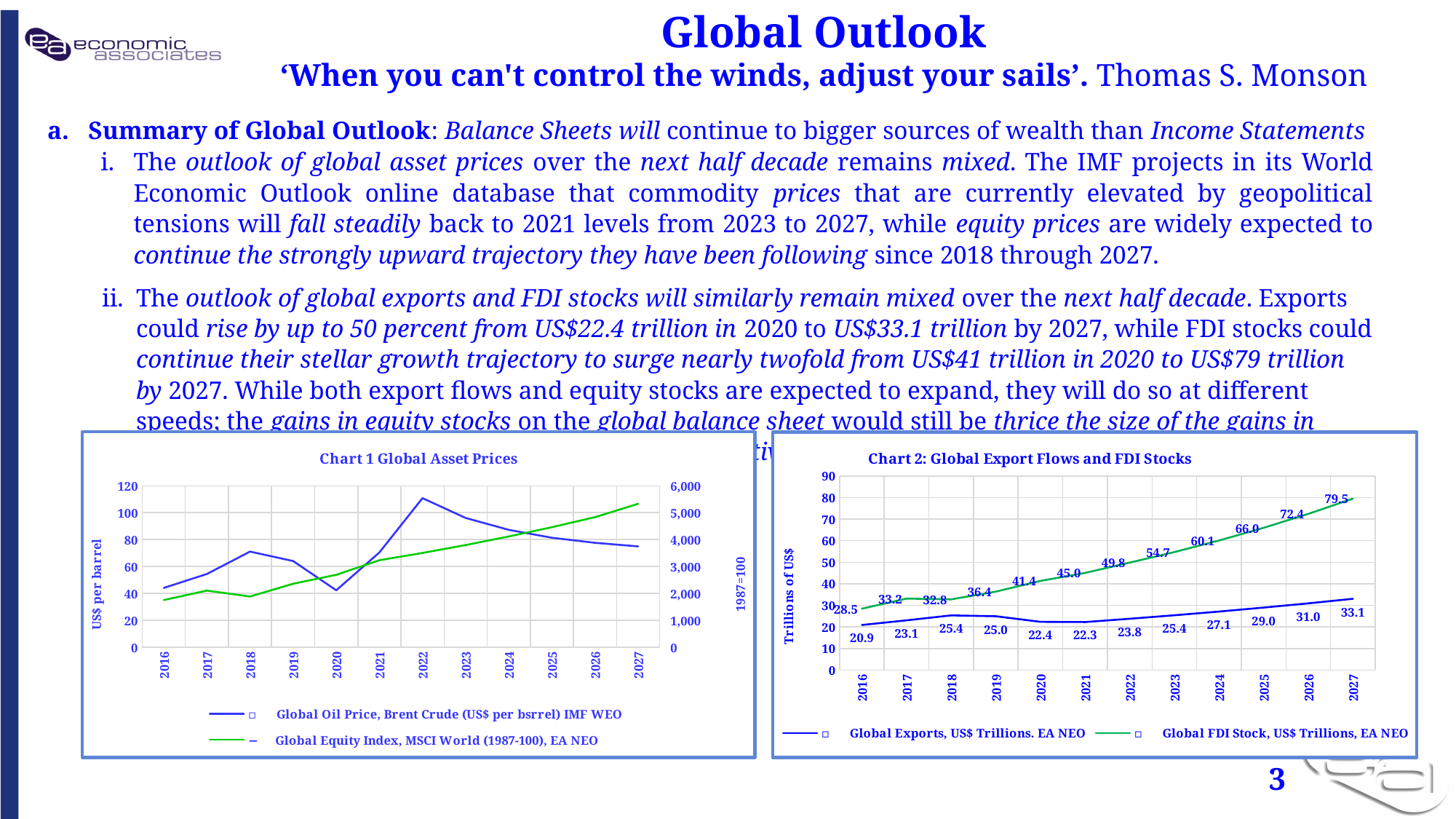
In Chart 1 Global Asset Prices, is the Global Oil Price in 2020 greater or less than 60? less In Chart 2: Global Export Flows and FDI Stocks, what is the value of Global Exports in 2020? 22.4 In Chart 2: Global Export Flows and FDI Stocks, in which year is Global FDI Stock highest? 2027 How many series does the legend of Chart 1 Global Asset Prices list? 2 In Chart 2: Global Export Flows and FDI Stocks, which is larger in 2016, Global Exports or Global FDI Stock? Global FDI Stock In Chart 2: Global Export Flows and FDI Stocks, what is the difference between Global FDI Stock and Global Exports in 2027? 46.4 What kind of chart is Chart 1 Global Asset Prices? Line chart In Chart 1 Global Asset Prices, does the Global Equity Index rise or fall from 2016 to 2027? Rises In Chart 1 Global Asset Prices, is the Global Oil Price in 2022 greater or less than 100? greater In Chart 2: Global Export Flows and FDI Stocks, how many years are plotted on the x axis? 12 In Chart 2: Global Export Flows and FDI Stocks, in which year is Global Exports lowest? 2016 In Chart 2: Global Export Flows and FDI Stocks, what is the value of Global FDI Stock in 2027? 79.5